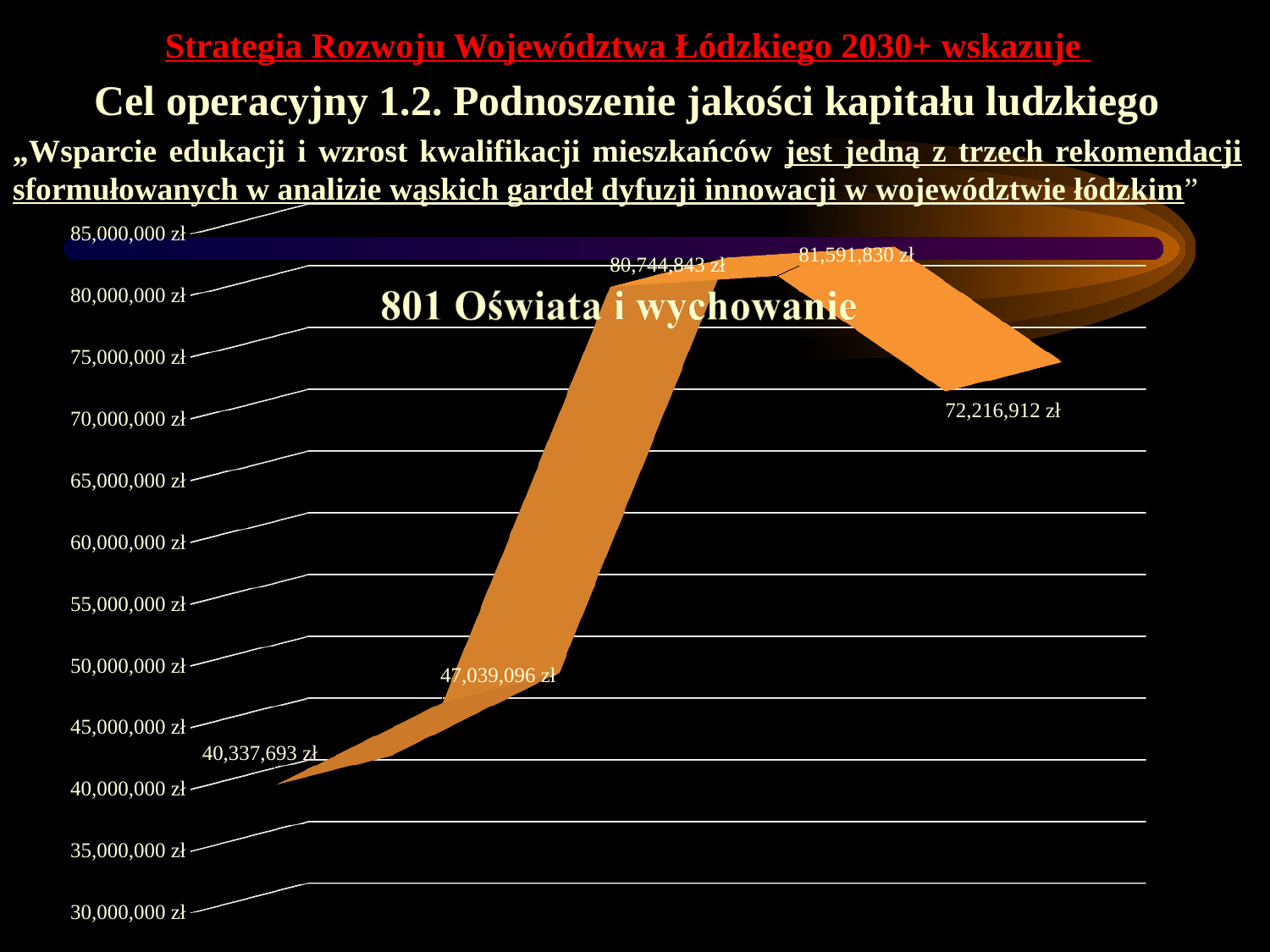
What is the title of the chart? 801 Oświata i wychowanie What is the value of the last (rightmost) data point on the chart? 72,216,912 zł Which is larger, the third data point (80,744,843 zł) or the last data point (72,216,912 zł)? the third data point (80,744,843 zł) What is the value of the first (leftmost) data point on the chart? 40,337,693 zł How many data points are plotted on the chart? 5 What kind of chart is shown on the slide? line chart What is the difference between the highest and lowest values on the chart? 41,254,137 zł What is the difference between the last data point and the first data point? 31,879,219 zł What is the value of the second data point on the chart? 47,039,096 zł What is the highest value shown on the chart? 81,591,830 zł What is the lowest value shown on the chart? 40,337,693 zł Do the values rise or fall between the first and fourth data points? rise